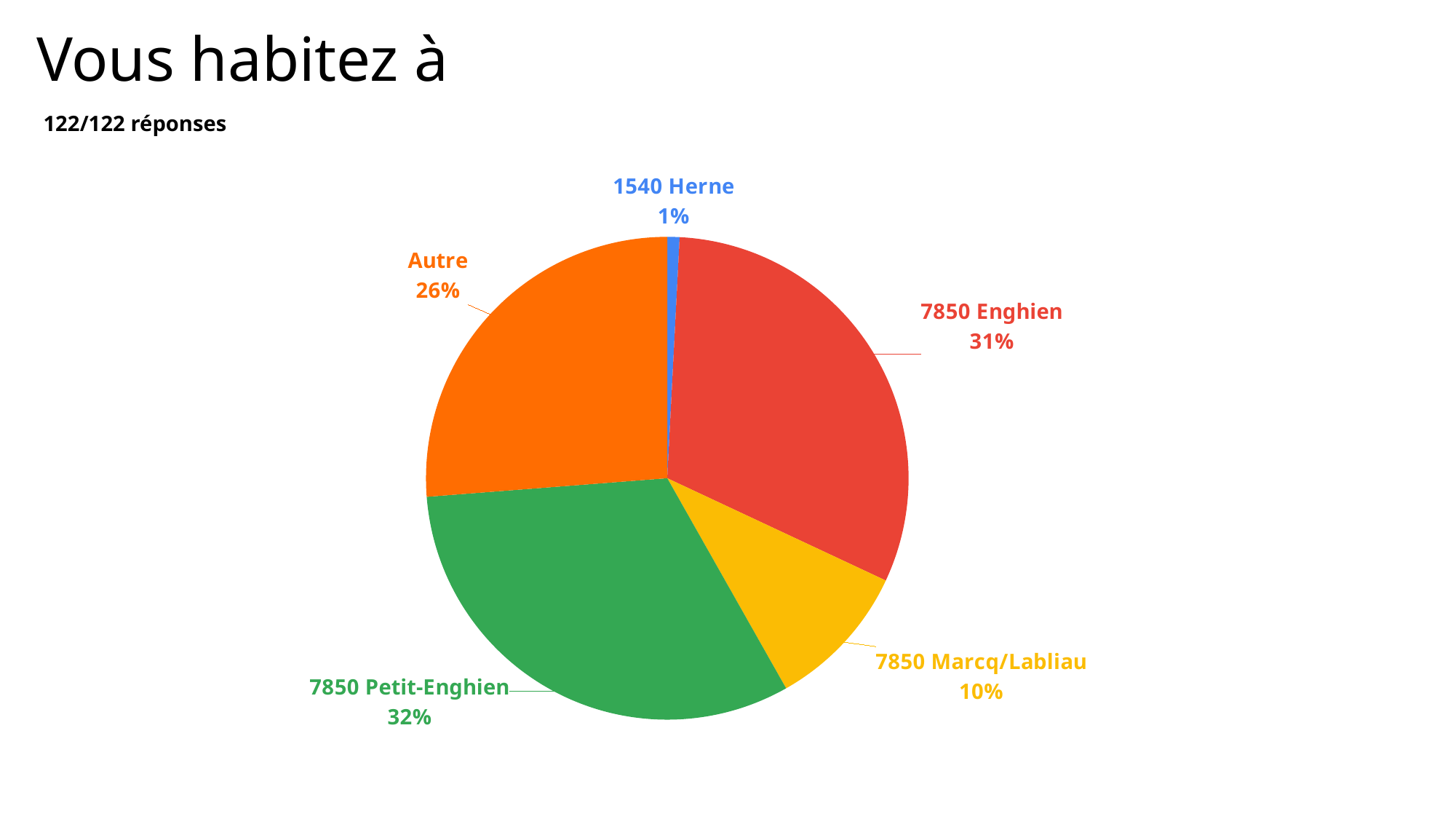
What is the difference in percentage points between Autre and 7850 Marcq/Labliau? 16 What kind of chart is shown on the slide? pie chart How many slices does the pie chart have? 5 What share of the pie does 7850 Enghien represent? 31% Which is larger, the share for Autre or the share for 7850 Marcq/Labliau? Autre Which category has the smallest slice of the pie? 1540 Herne What share of the pie does 7850 Marcq/Labliau represent? 10% What is the title of the chart? Vous habitez à What share of the pie does 7850 Petit-Enghien represent? 32% How many responses does the slide say the chart is based on? 122/122 réponses